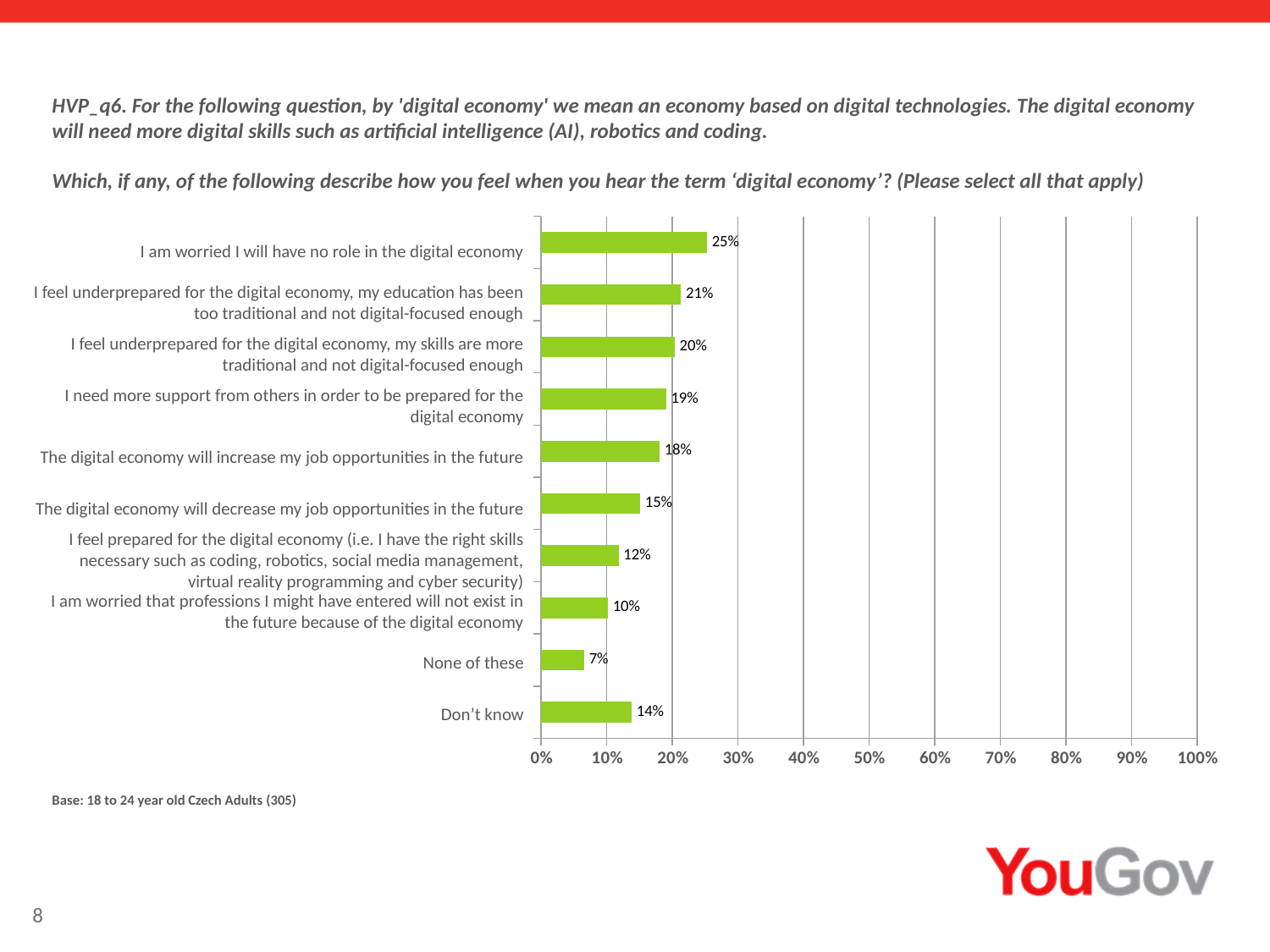
What is the value for 'None of these'? 7% What is the value for 'The digital economy will increase my job opportunities in the future'? 18% What percentage of respondents selected 'Don't know'? 14% How many response categories are shown in the chart? 10 Which response has the lowest percentage? None of these What type of chart is shown on the slide? Bar chart What percentage of respondents said 'I am worried I will have no role in the digital economy'? 25% What is the difference between 'I am worried I will have no role in the digital economy' and 'Don't know'? 11 percentage points Which response has the highest percentage? I am worried I will have no role in the digital economy Which is larger: 'The digital economy will increase my job opportunities in the future' or 'The digital economy will decrease my job opportunities in the future'? The digital economy will increase my job opportunities in the future Is the value for 'I feel prepared for the digital economy (i.e. I have the right skills necessary such as coding, robotics, social media management, virtual reality programming and cyber security)' greater or less than 20%? less What is the maximum value shown on the horizontal axis? 100%